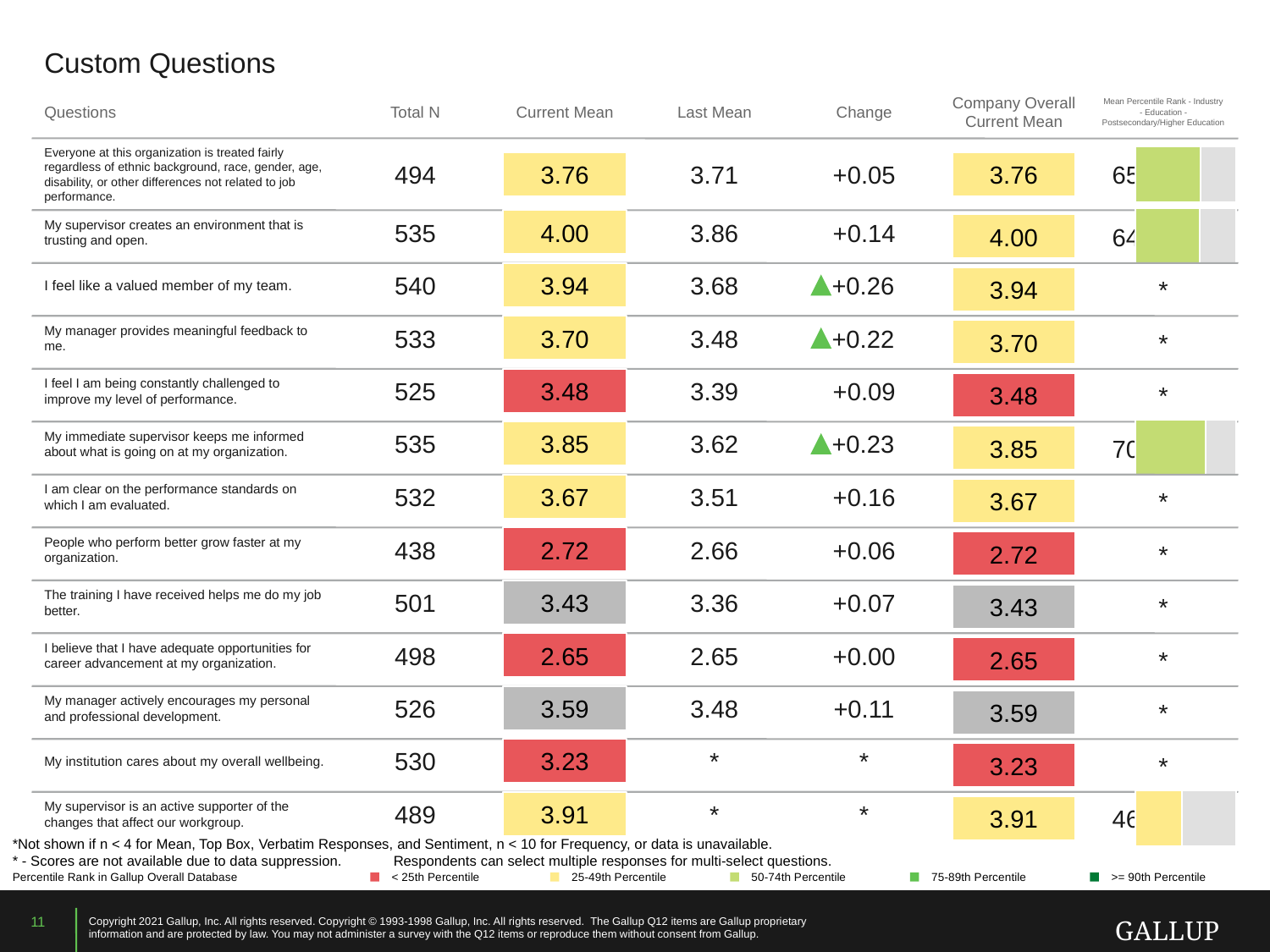
What is the Last Mean for "My manager provides meaningful feedback to me."? 3.48 Which question has the highest Current Mean? My supervisor creates an environment that is trusting and open. What is the Current Mean for "My supervisor creates an environment that is trusting and open."? 4.00 Which question has the smallest Total N? People who perform better grow faster at my organization. How many custom questions are listed in the table? 13 What is the Change value for "My immediate supervisor keeps me informed about what is going on at my organization."? +0.23 Which has the higher Current Mean: "The training I have received helps me do my job better." or "My manager actively encourages my personal and professional development."? My manager actively encourages my personal and professional development. What is the difference between the Current Mean and the Last Mean for "I am clear on the performance standards on which I am evaluated."? 0.16 What is the Current Mean for "My institution cares about my overall wellbeing."? 3.23 Which question has the lowest Current Mean? I believe that I have adequate opportunities for career advancement at my organization. What colour is the Current Mean cell for "People who perform better grow faster at my organization."? Red What is the Total N for "I feel like a valued member of my team."? 540